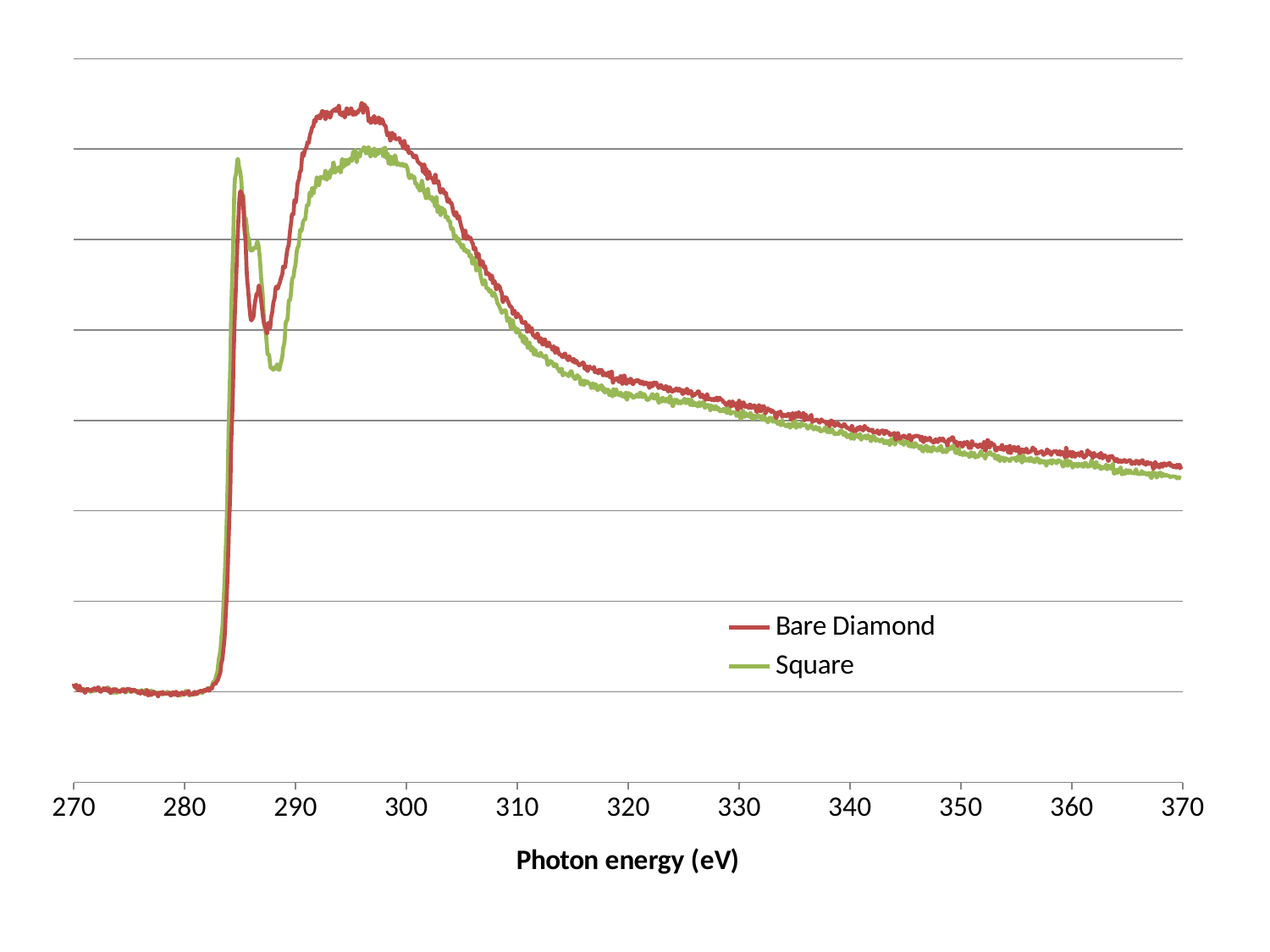
How many tick labels are shown on the x axis? 11 How many series does the legend list? 2 Which series is higher at a photon energy of 360 eV, Bare Diamond or Square? Bare Diamond What is the label of the x axis? Photon energy (eV) Which series has the higher sharp peak near 285 eV, Bare Diamond or Square? Square Which series is higher at a photon energy of 300 eV, Bare Diamond or Square? Bare Diamond What are the names of the two series in the legend? Bare Diamond and Square What is the lowest photon energy shown on the x axis? 270 What kind of chart is shown on the slide? line chart Do the values of the Square series rise or fall between 288 eV and 296 eV? rise What is the highest photon energy shown on the x axis? 370 Do the values of the Bare Diamond series rise or fall between 300 eV and 370 eV? fall